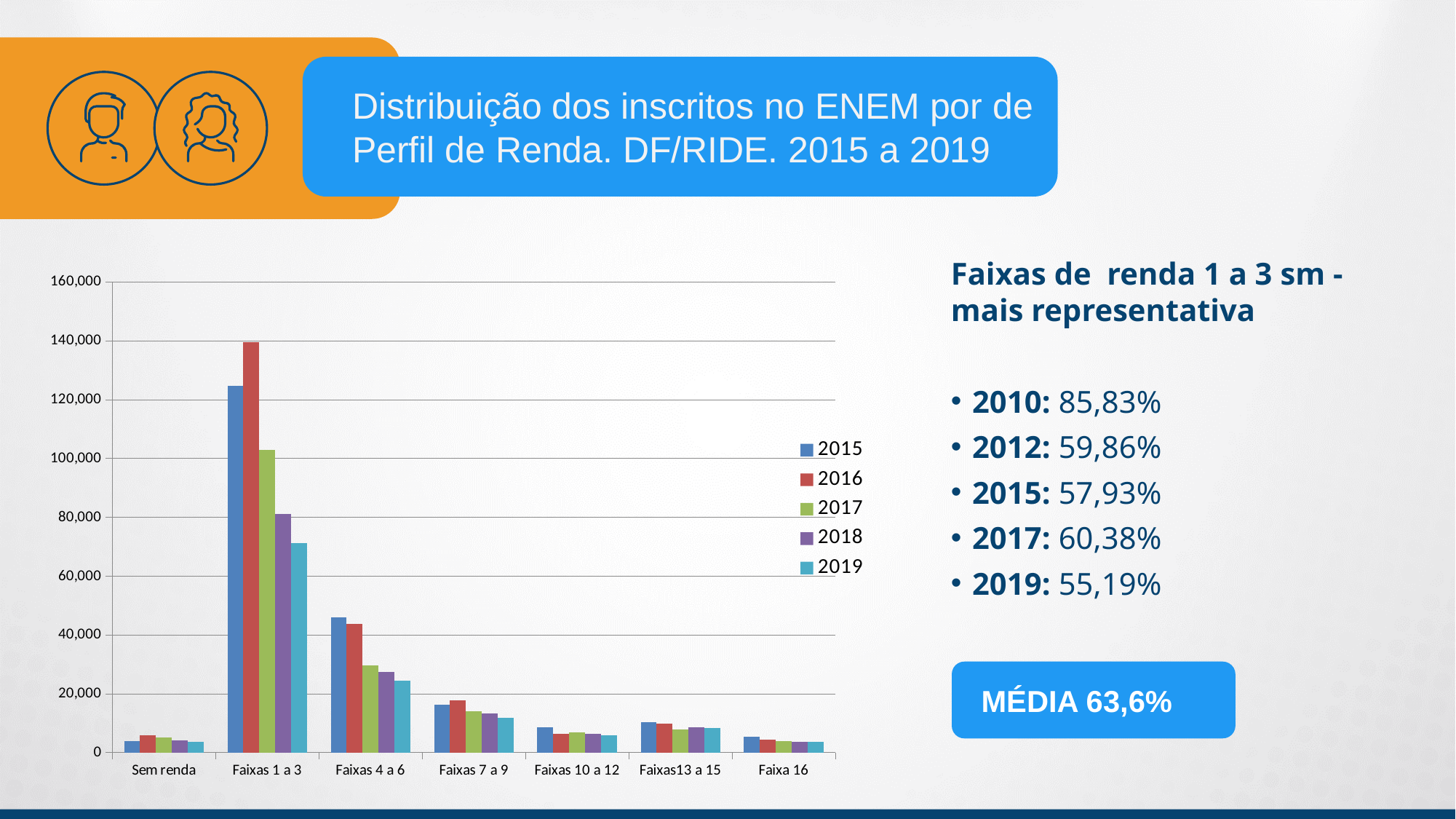
Is the value for 2015 in Faixas 4 a 6 greater or less than 40,000? greater How many income categories are shown on the x axis of the chart? 7 In the Faixas 1 a 3 category, which is larger: the 2015 bar or the 2019 bar? 2015 Is the value for 2019 in Faixas 1 a 3 greater or less than 80,000? less Which year is represented by the red bars in the chart? 2016 How many series does the chart legend list? 5 Within the Faixas 1 a 3 category, which year has the tallest bar? 2016 Is the value for 2015 in Faixas 1 a 3 greater or less than 120,000? greater Which income category has the highest bars in the chart? Faixas 1 a 3 What kind of chart is shown on the slide? bar chart Within the Faixas 1 a 3 category, which year has the shortest bar? 2019